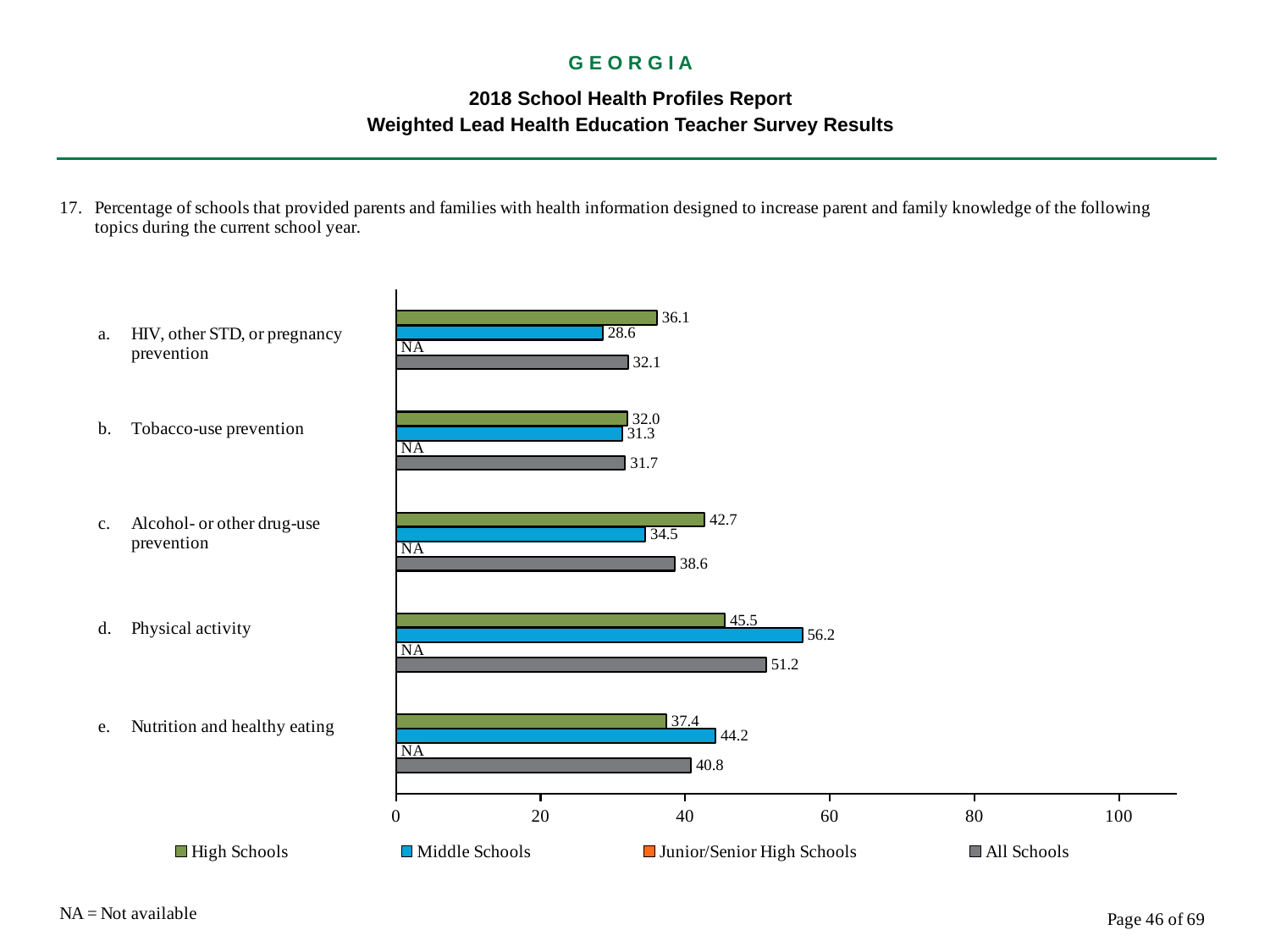
Is the All Schools value for Physical activity greater or less than 40? greater What is the value for Middle Schools for HIV, other STD, or pregnancy prevention? 28.6 Which topic has the lowest value for All Schools? Tobacco-use prevention What value is shown for Junior/Senior High Schools for Tobacco-use prevention? NA How many topics are listed on the chart? 5 What kind of chart is shown on the slide? bar chart For Nutrition and healthy eating, which is larger: the High Schools value or the Middle Schools value? Middle Schools Which topic has the highest value for Middle Schools? Physical activity What is the value for High Schools for Physical activity? 45.5 What is the difference between the Middle Schools and High Schools values for Physical activity? 10.7 How many series does the legend list? 4 What is the value for All Schools for Nutrition and healthy eating? 40.8